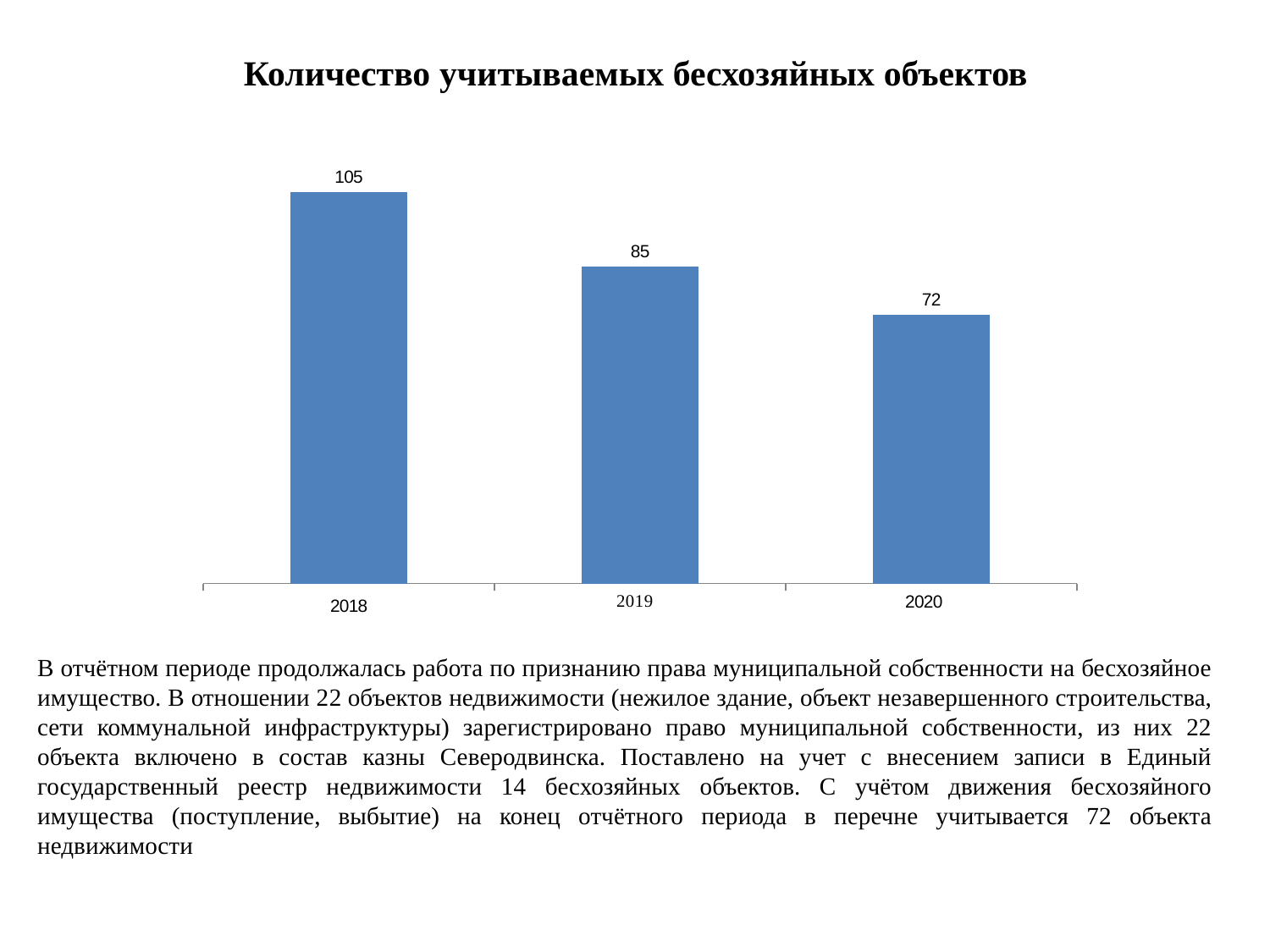
What is the value for 2018? 105 How many bars are shown in the chart? 3 Do the values rise or fall from 2018 to 2020? fall What is the difference between the values for 2019 and 2020? 13 What is the difference between the values for 2018 and 2020? 33 What kind of chart is shown on the slide? bar chart Which is larger, the value for 2018 or the value for 2019? 2018 What is the value for 2020? 72 What is the title of the chart? Количество учитываемых бесхозяйных объектов Which year has the highest value? 2018 Which year has the lowest value? 2020 What is the value for 2019? 85